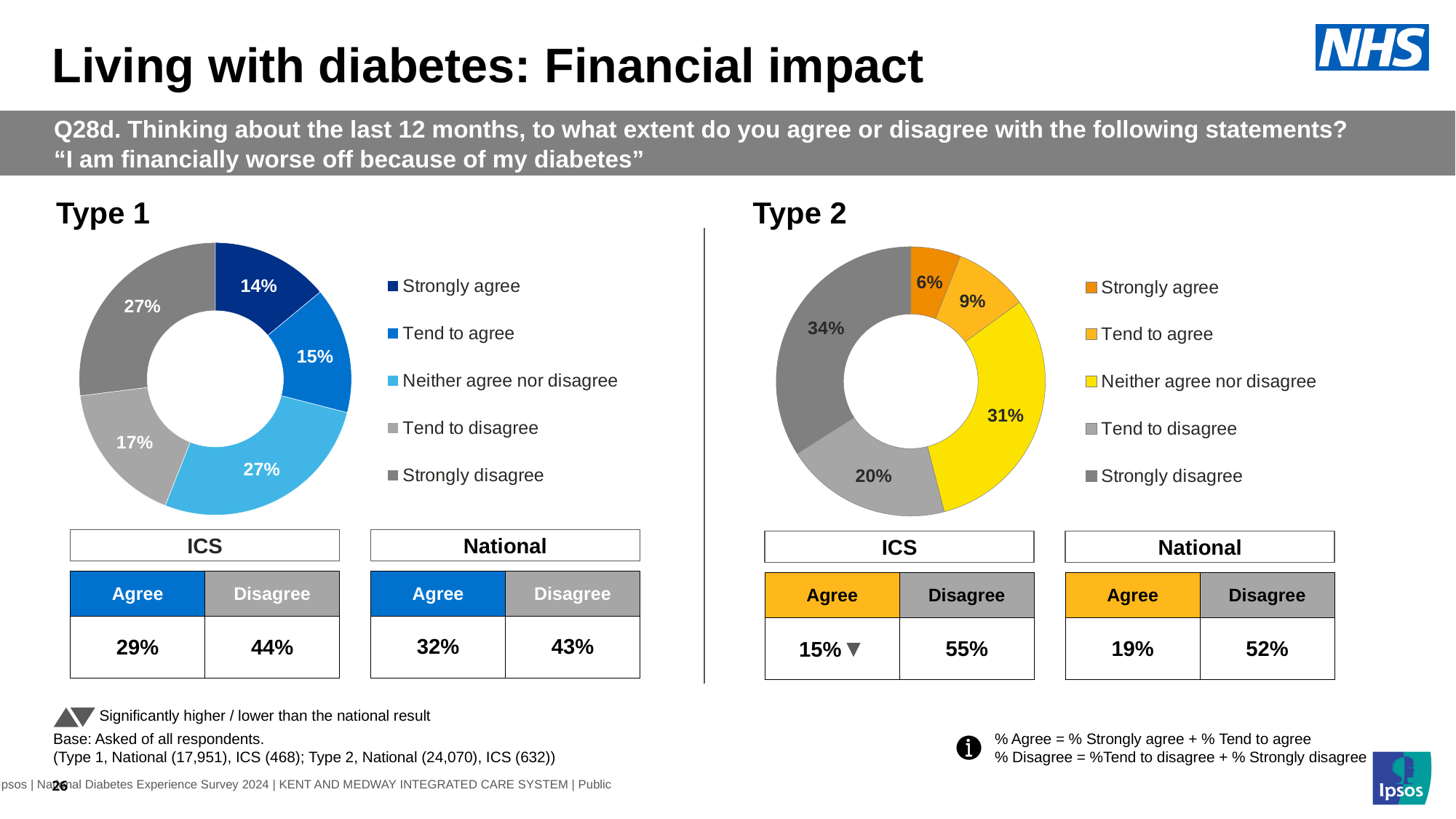
In the Type 1 chart, what is the difference between the 'Neither agree nor disagree' share and the 'Tend to agree' share? 12 percentage points In the Type 1 chart, what colour is the 'Strongly agree' segment? Dark blue In the Type 1 chart, what percentage of respondents said 'Tend to disagree'? 17% In the Type 2 chart, which category has the largest share? Strongly disagree Which is larger in the Type 1 chart: the 'Strongly disagree' share or the 'Tend to disagree' share? Strongly disagree What kind of chart is used for the Type 1 data? Pie chart (donut) In the Type 2 chart, which category has the smallest share? Strongly agree How many categories does the Type 2 chart's legend list? 5 In the Type 2 chart, what is the difference between the 'Strongly disagree' share and the 'Tend to disagree' share? 14 percentage points In the Type 2 chart, what percentage of respondents said 'Tend to agree'? 9% In the Type 1 chart, what percentage of respondents said 'Strongly agree'? 14% In the Type 2 chart, what percentage of respondents said 'Neither agree nor disagree'? 31%